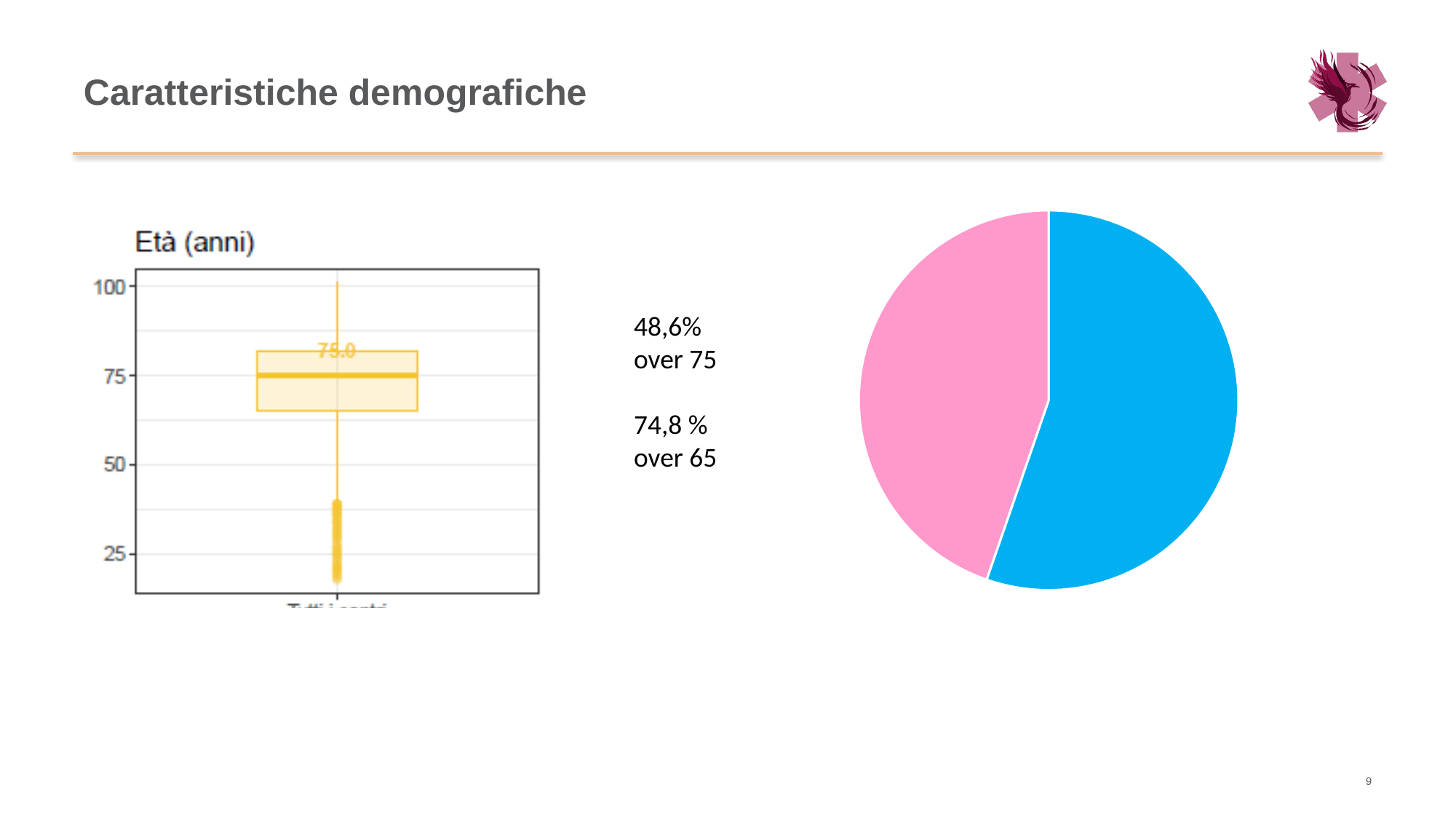
In the pie chart on the right of the slide, which slice is larger, the blue one or the pink one? the blue one In the Età (anni) box plot, is the lowest plotted point greater or less than 25? less In the Età (anni) box plot, what is the median value printed on the box? 75.0 What is the highest tick value on the y axis of the Età (anni) box plot? 100 What two colours are used for the slices of the pie chart on the right of the slide? blue and pink How many boxes are drawn in the Età (anni) box plot? 1 What kind of chart is the chart on the right of the slide? pie chart In the Età (anni) box plot, is the median greater or less than 50? greater How many slices does the pie chart on the right of the slide have? 2 What is the title of the chart on the left of the slide? Età (anni) What kind of chart is the chart on the left of the slide? box plot In the Età (anni) box plot, is the top edge of the box greater or less than 100? less